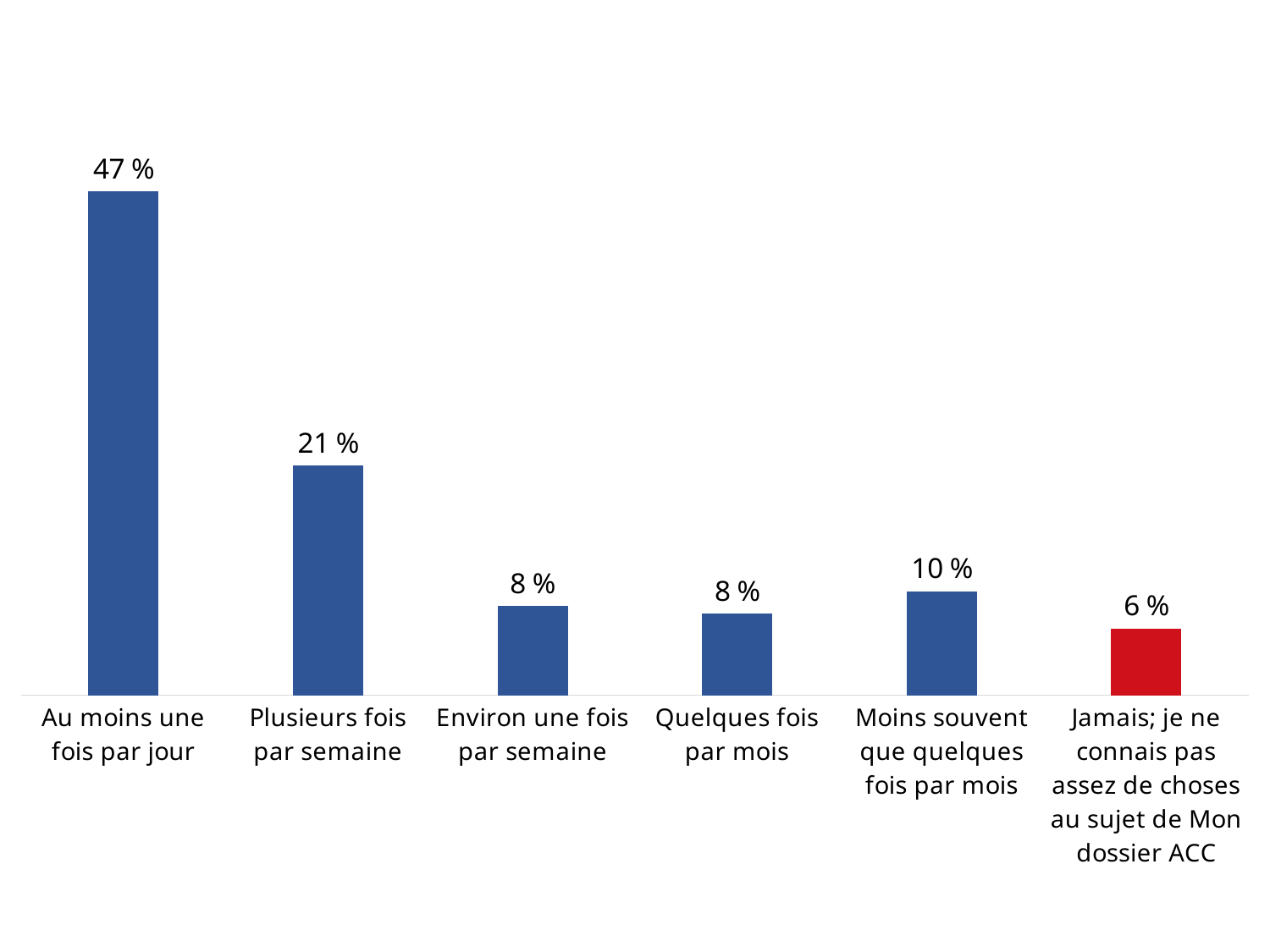
What kind of chart is this? Bar chart What is the value for "Moins souvent que quelques fois par mois"? 10 % What is the value for "Plusieurs fois par semaine"? 21 % What is the value for "Au moins une fois par jour"? 47 % How many categories are shown in the chart? 6 Which category has the lowest value? Jamais; je ne connais pas assez de choses au sujet de Mon dossier ACC Which is larger, the value for "Moins souvent que quelques fois par mois" or the value for "Quelques fois par mois"? Moins souvent que quelques fois par mois Which category has the highest value? Au moins une fois par jour Which bar is coloured red rather than blue? Jamais; je ne connais pas assez de choses au sujet de Mon dossier ACC What is the combined value of "Environ une fois par semaine" and "Quelques fois par mois"? 16 % What is the difference between the values for "Au moins une fois par jour" and "Plusieurs fois par semaine"? 26 % What is the value for "Jamais; je ne connais pas assez de choses au sujet de Mon dossier ACC"? 6 %